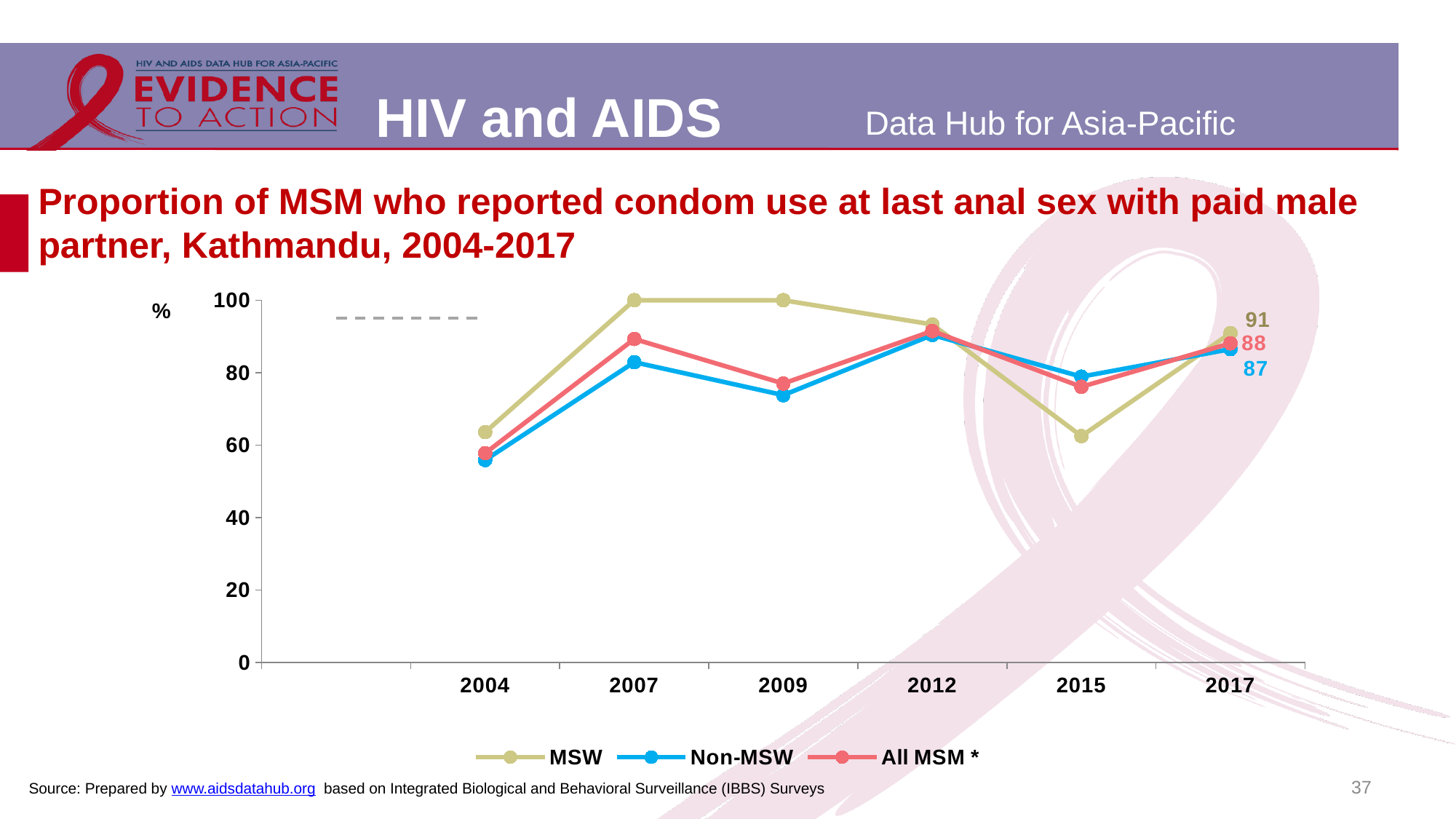
What is the value for Non-MSW in 2017? 87 In 2015, which is larger: MSW or Non-MSW? Non-MSW Is the value for Non-MSW in 2004 greater or less than 60? less What is the value for MSW in 2017? 91 Which series has the highest value in 2017? MSW Does the MSW line rise or fall from 2012 to 2015? Fall How many years are shown on the x axis? 6 How many series does the legend list? 3 What is the difference between the MSW and Non-MSW values in 2017? 4 Is the value for MSW in 2015 greater or less than 80? less What is the value for All MSM * in 2017? 88 What kind of chart is shown on the slide? Line chart